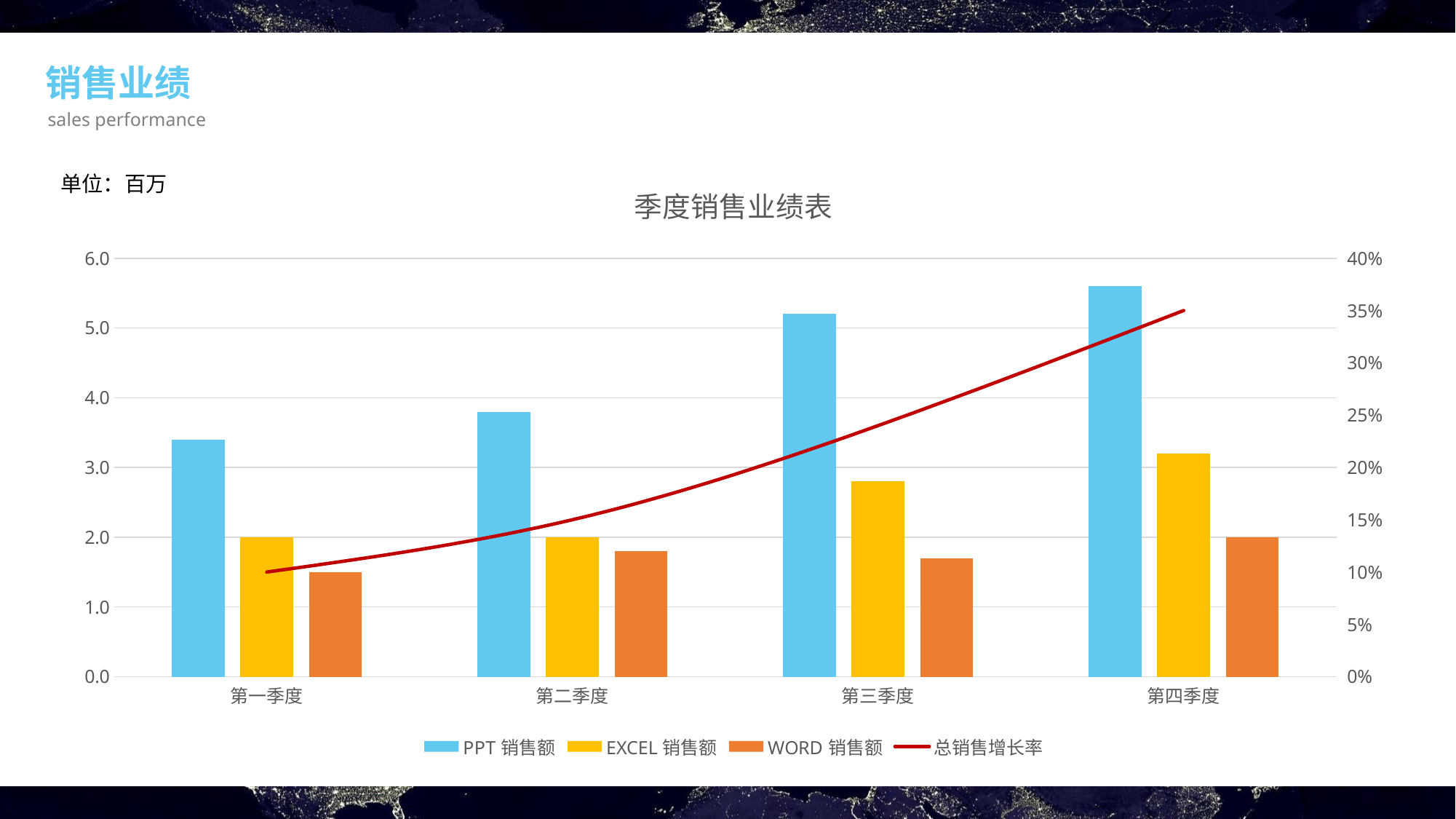
What is the title of the chart? 季度销售业绩表 Does the 总销售增长率 line rise or fall from 第一季度 to 第四季度? rise What is the WORD 销售额 value for 第四季度? 2.0 In which quarter is the PPT 销售额 bar the highest? 第四季度 What is the EXCEL 销售额 value for 第一季度? 2.0 How many quarters (categories) are shown on the x axis? 4 What kind of chart is shown on the slide? bar chart with a line How many series does the legend list? 4 Is the PPT 销售额 value for 第一季度 greater or less than 4.0? less In which quarter is the WORD 销售额 bar the lowest? 第一季度 Is the PPT 销售额 value for 第三季度 greater or less than 5.0? greater In 第二季度, which is larger: PPT 销售额 or EXCEL 销售额? PPT 销售额